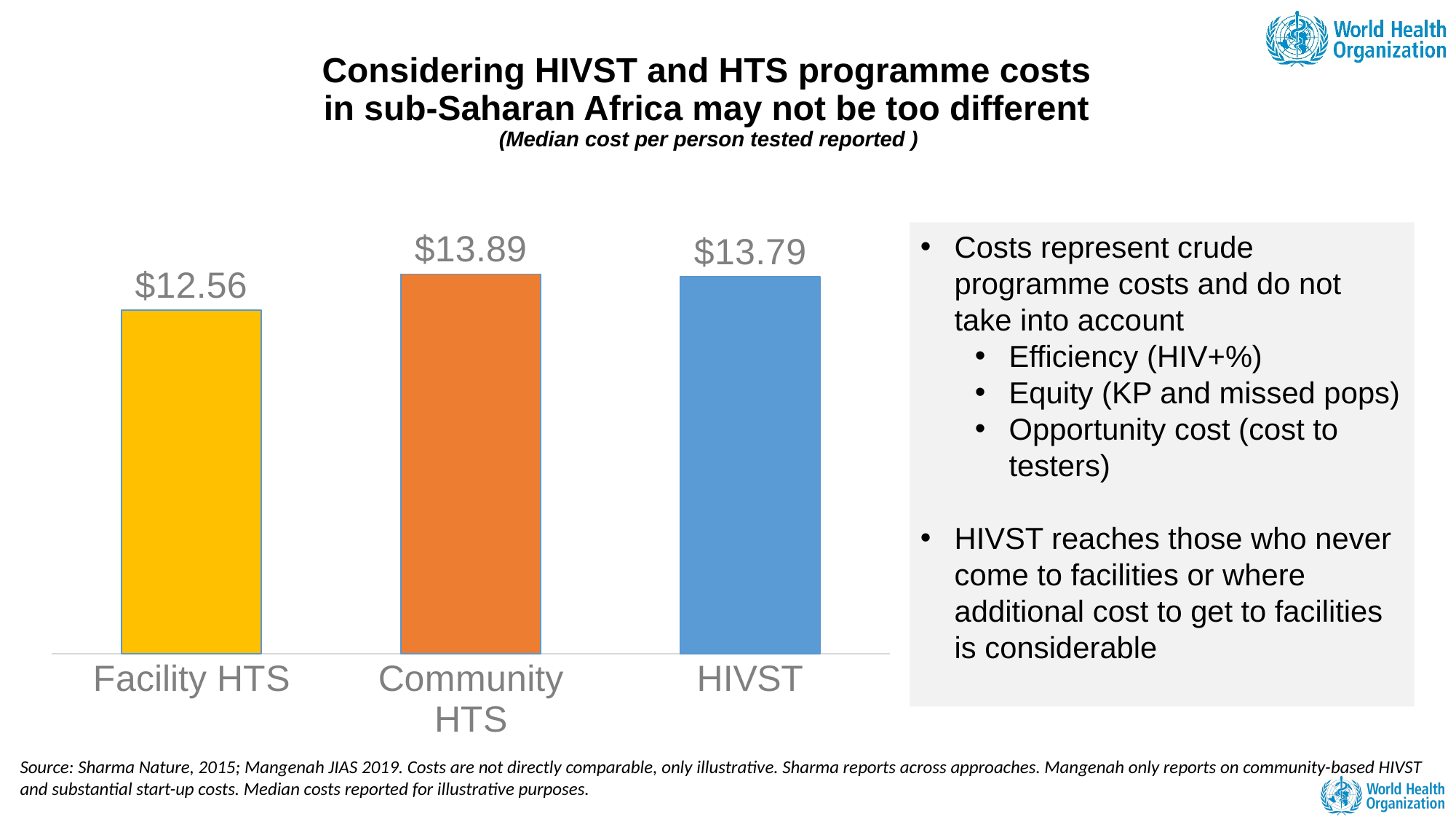
How many categories are shown in the chart? 3 Which category has the lowest median cost per person tested? Facility HTS What kind of chart is shown on the slide? Bar chart What is the difference between the Community HTS and Facility HTS costs? $1.33 What is the median cost per person tested for HIVST? $13.79 What is the median cost per person tested for Facility HTS? $12.56 What is the median cost per person tested for Community HTS? $13.89 What colour is the HIVST bar? Blue Which has a higher median cost per person tested, Facility HTS or HIVST? HIVST What is the difference between the Community HTS and HIVST costs? $0.10 What is the difference between the HIVST and Facility HTS costs? $1.23 Which category has the highest median cost per person tested? Community HTS